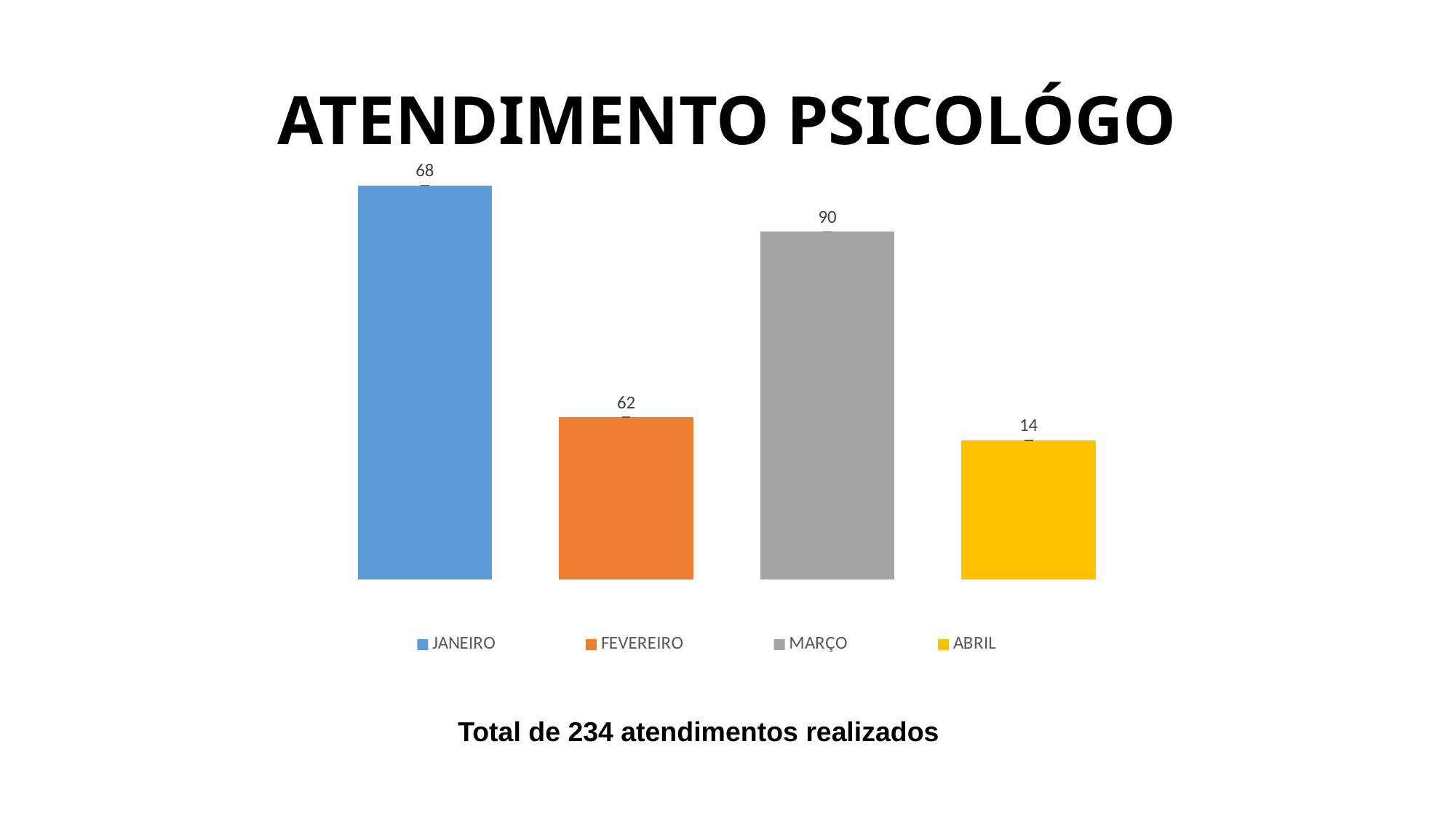
What kind of chart is shown on the slide? Bar chart What is the value for FEVEREIRO? 62 What is the difference between the values for MARÇO and JANEIRO? 22 How many bars are shown in the chart? 4 What is the difference between the values for FEVEREIRO and ABRIL? 48 Which month has the lowest value? ABRIL What is the title of the chart? ATENDIMENTO PSICOLÓGO What is the value for ABRIL? 14 What is the value for JANEIRO? 68 Which is larger, the value for JANEIRO or the value for FEVEREIRO? JANEIRO What is the value for MARÇO? 90 Which month has the highest value? MARÇO